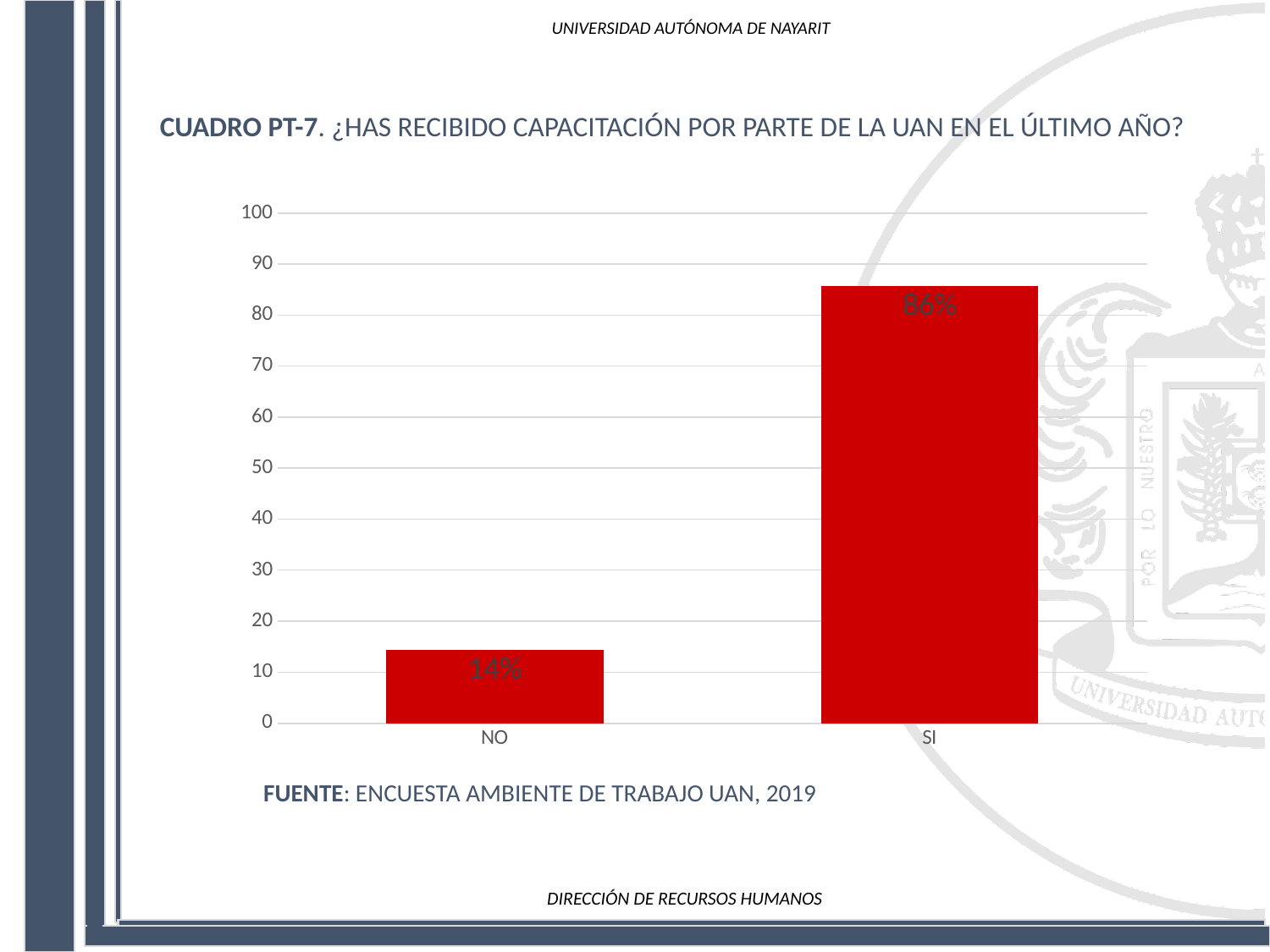
What is the value for SI? 86% Which is larger, the value for NO or the value for SI? SI What is the value for NO? 14% Which category has the lowest value? NO What kind of chart is shown on the slide? bar chart What is the maximum value shown on the y axis? 100 How many categories are shown on the x axis? 2 Which category has the highest value? SI What source is cited below the chart? ENCUESTA AMBIENTE DE TRABAJO UAN, 2019 Is the value for SI greater or less than 80? greater Is the value for NO greater or less than 20? less What is the difference between the values for SI and NO? 72%